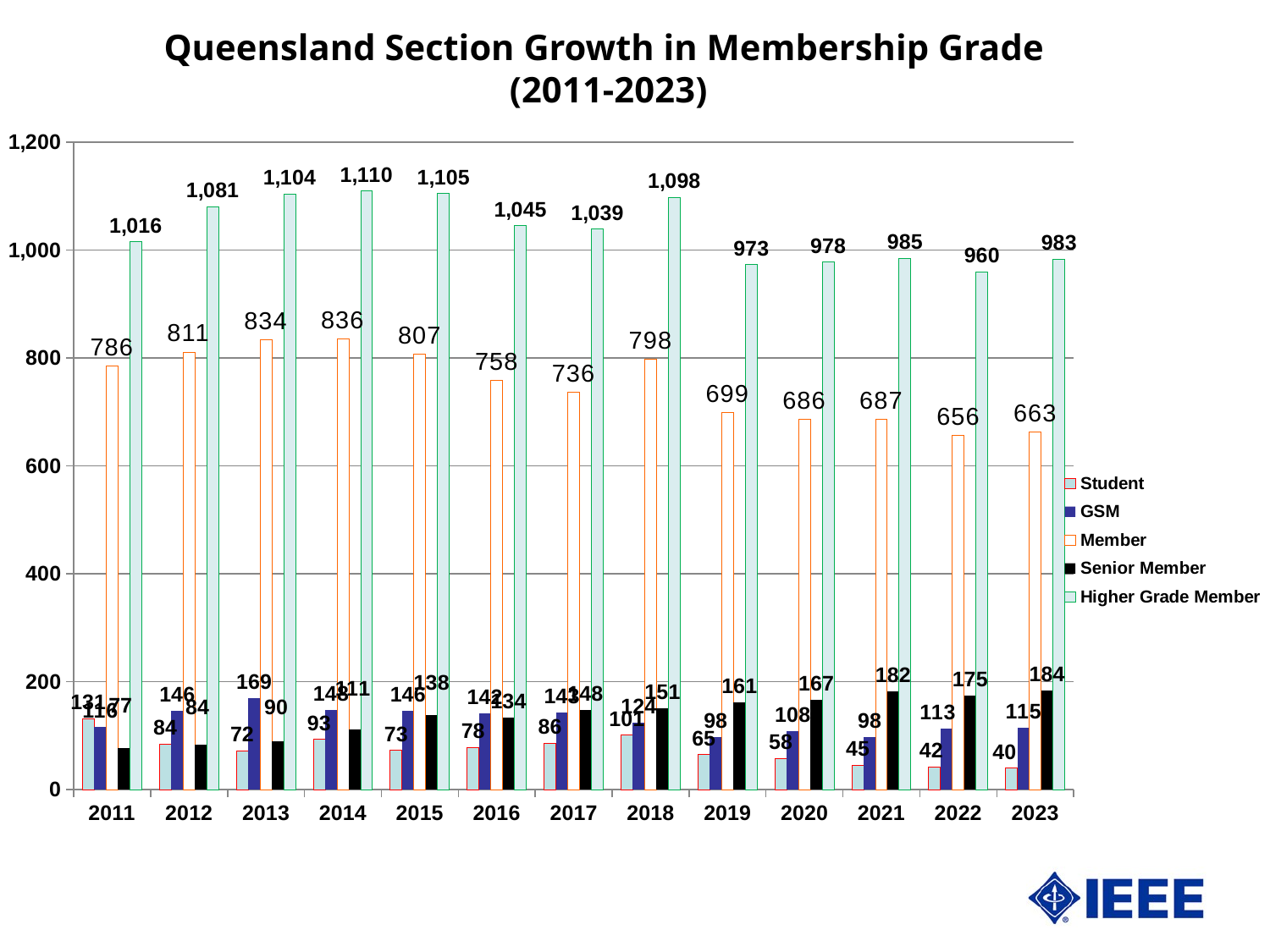
What is the Member value for 2011? 786 How many years are shown on the x axis? 13 In which year is the Higher Grade Member value highest? 2014 What is the Higher Grade Member value for 2014? 1,110 What kind of chart is shown on the slide? bar chart What is the Senior Member value for 2023? 184 In which year is the Member value lowest? 2022 How many series does the legend list? 5 Do the Student values rise or fall from 2018 to 2023? fall Is the Higher Grade Member value for 2022 greater or less than 1,000? less In 2023, which is larger: the Senior Member value or the Student value? Senior Member What is the difference between the Member value in 2013 and the Member value in 2023? 171